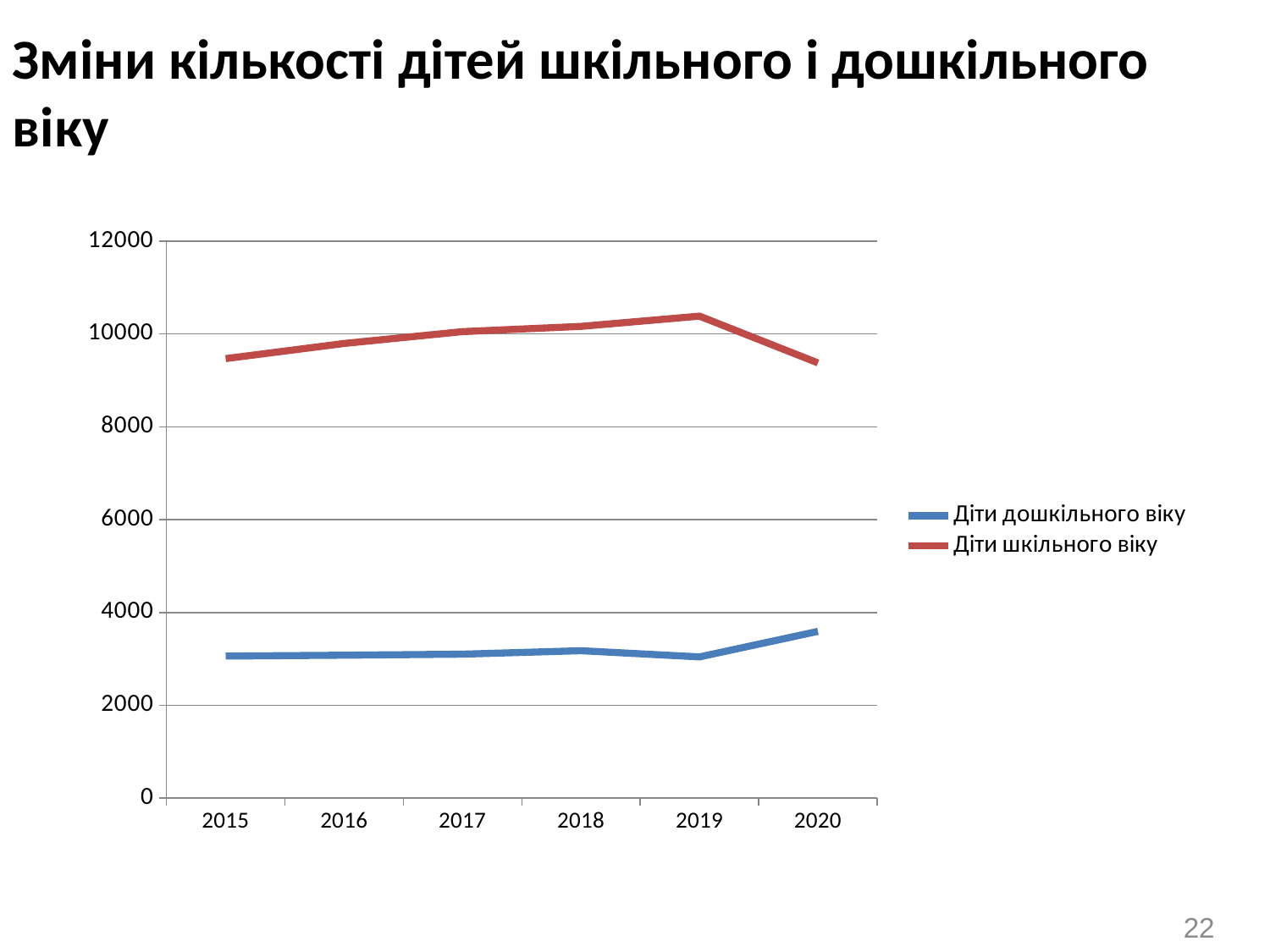
In which year does the series "Діти шкільного віку" reach its highest value? 2019 How many series does the legend list? 2 Is the value for "Діти шкільного віку" in 2015 greater or less than 10000? less Does the series "Діти дошкільного віку" rise or fall from 2019 to 2020? rise Is the value for "Діти шкільного віку" in 2019 greater or less than 10000? greater Does the series "Діти шкільного віку" rise or fall from 2019 to 2020? fall How many years are plotted along the x axis? 6 What kind of chart is shown on the slide? line chart What colour is the line for "Діти шкільного віку"? red Is the value for "Діти дошкільного віку" in 2020 greater or less than 4000? less In which year does the series "Діти дошкільного віку" reach its highest value? 2020 Which series has the larger value in 2018, "Діти дошкільного віку" or "Діти шкільного віку"? Діти шкільного віку